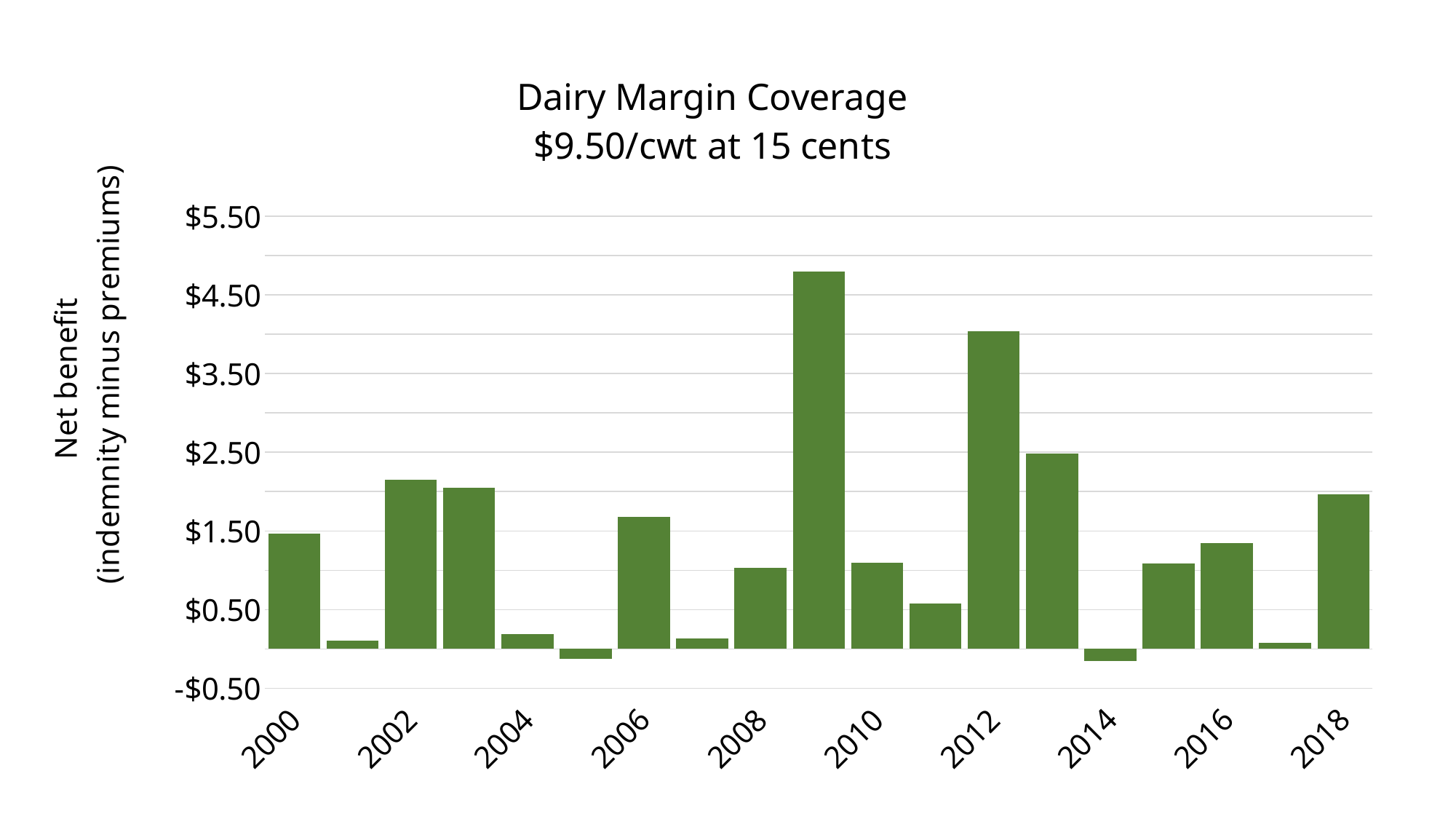
Is the value for 2012 greater or less than $3.50? greater Which year has the larger net benefit, 2009 or 2012? 2009 What is the title of the chart? Dairy Margin Coverage $9.50/cwt at 15 cents Is the value for 2011 greater or less than $1.50? less Is the value for 2018 greater or less than $1.50? greater How many years (bars) are plotted in the chart? 19 Which year has the larger net benefit, 2006 or 2008? 2006 What is the label on the vertical axis? Net benefit (indemnity minus premiums) What kind of chart is shown on the slide? bar chart Which year has the highest net benefit? 2009